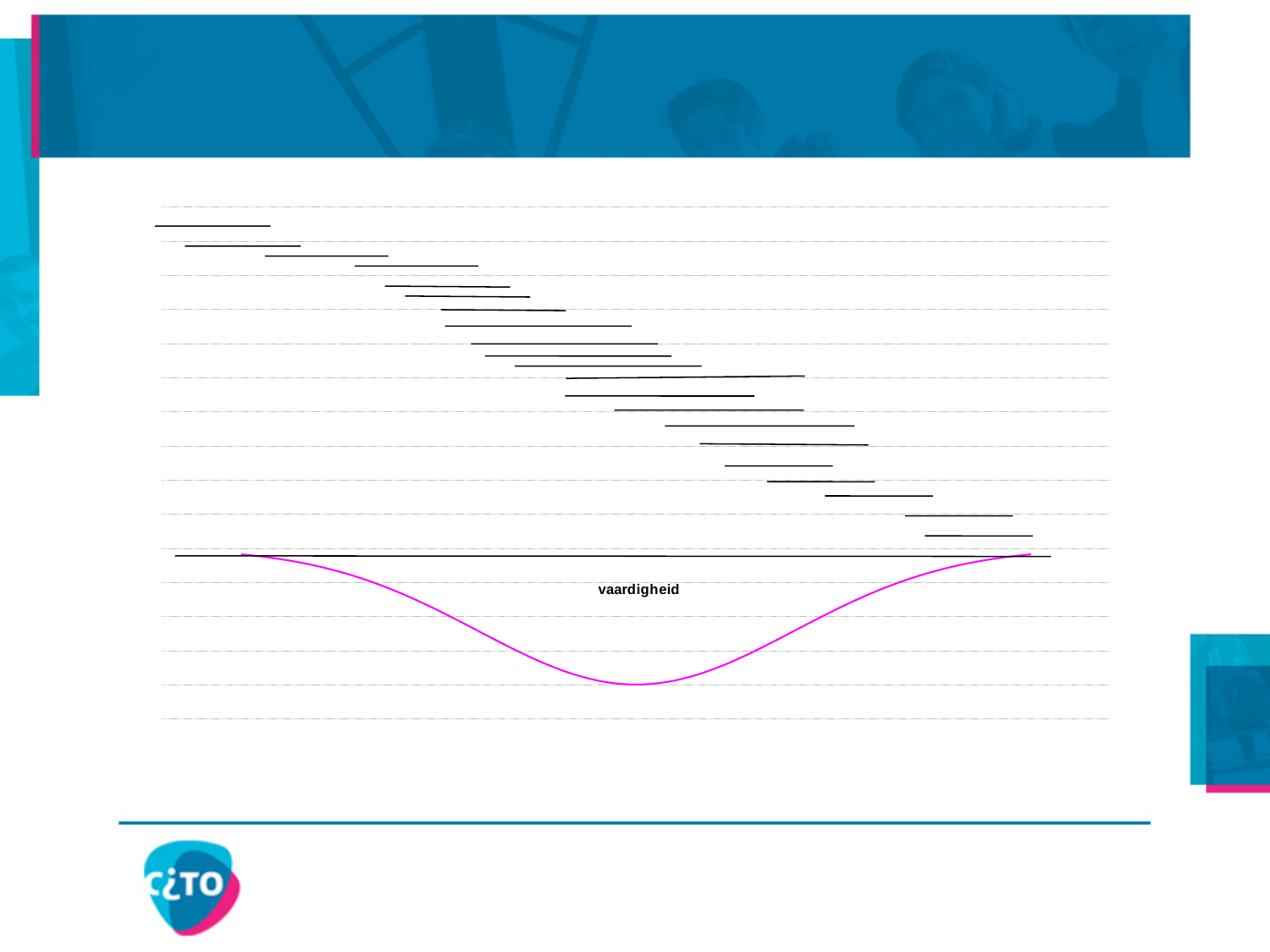
Does the magenta curve reach its lowest point near the left edge, the middle, or the right edge of the x axis? the middle Moving from left to right along the x axis, does the magenta curve first fall or first rise? fall What label is printed beneath the horizontal axis of the chart? vaardigheid What colour is the curved line plotted below the horizontal axis? magenta